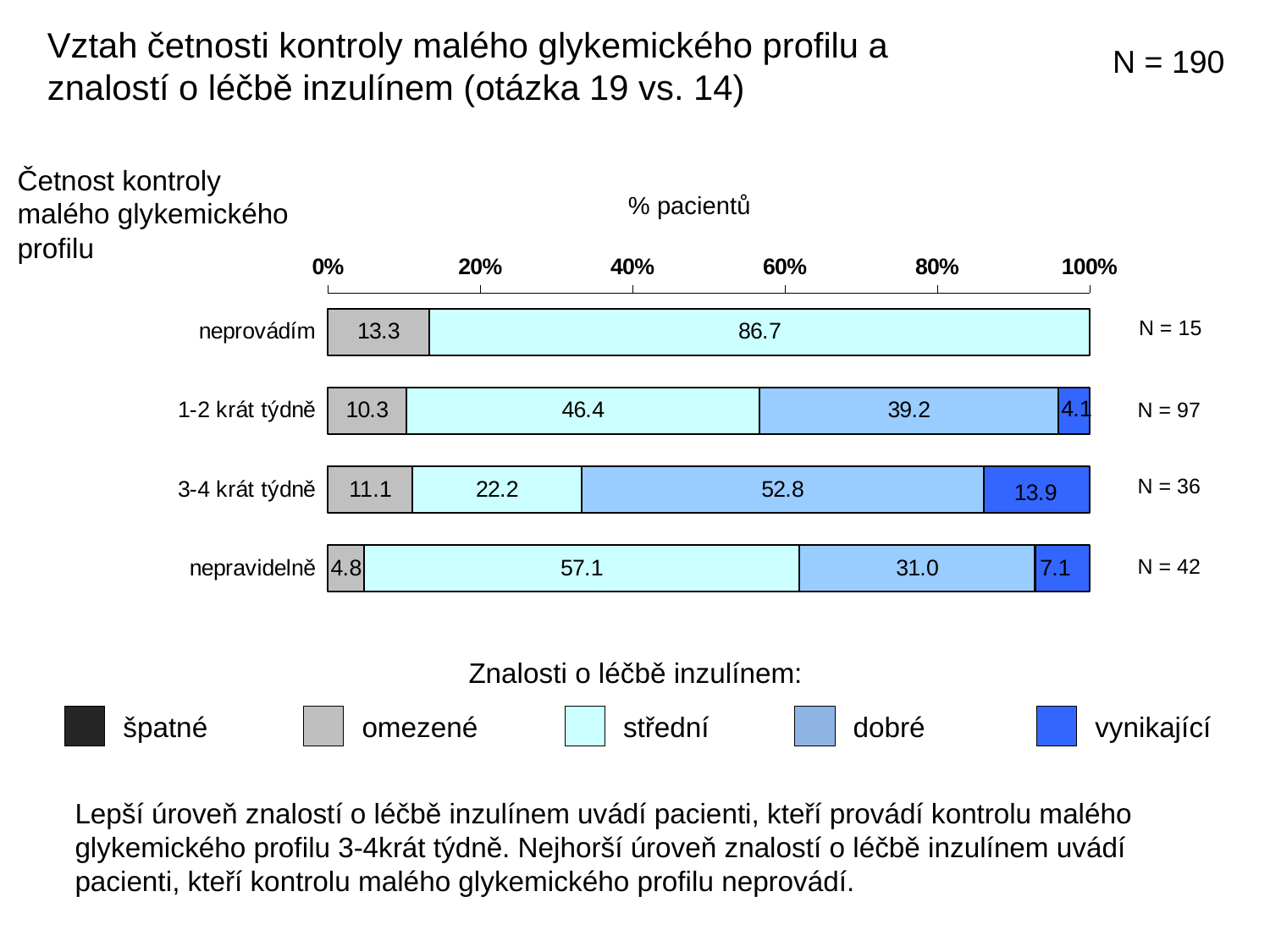
Which category has the lowest value for the 'omezené' segment? nepravidelně What is the sample size (N) shown next to the '1-2 krát týdně' bar? N = 97 Which category has the highest value for the 'vynikající' segment? 3-4 krát týdně How many series does the legend 'Znalosti o léčbě inzulínem' list? 5 What is the value of the 'vynikající' segment for the '1-2 krát týdně' category? 4.1 What is the value of the 'střední' segment for the 'neprovádím' category? 86.7 What kind of chart is shown on the slide? stacked bar chart Which is larger: the 'střední' value for '1-2 krát týdně' or for 'nepravidelně'? nepravidelně What is the value of the 'omezené' segment for the 'nepravidelně' category? 4.8 What is the difference between the 'dobré' values for '3-4 krát týdně' and '1-2 krát týdně'? 13.6 How many categories (frequency groups) are plotted on the y axis of the chart? 4 What is the value of the 'dobré' segment for the '3-4 krát týdně' category? 52.8